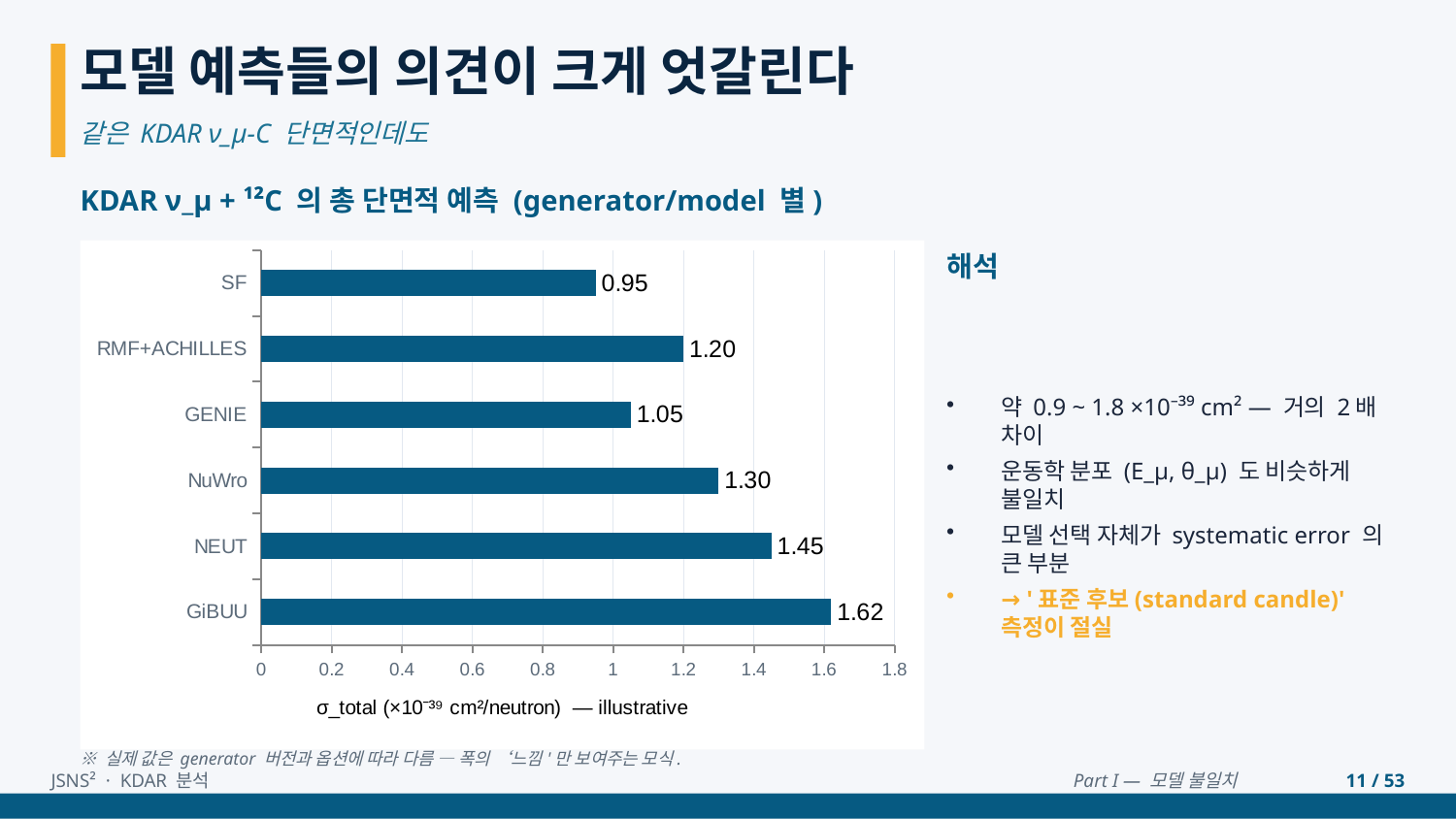
What kind of chart is shown on the slide? bar chart Which generator/model has the lowest value? SF Which generator/model has the highest value? GiBUU What is the value for RMF+ACHILLES? 1.20 What is the difference between the values for NEUT and NuWro? 0.15 What is the value for SF? 0.95 Which is larger, the value for GENIE or the value for RMF+ACHILLES? RMF+ACHILLES What is the difference between the values for GiBUU and SF? 0.67 Is the value for NEUT greater or less than 1.4? greater What is the value for GiBUU? 1.62 How many generators/models are shown in the chart? 6 What is the label of the horizontal axis of the chart? σ_total (×10⁻³⁹ cm²/neutron) — illustrative